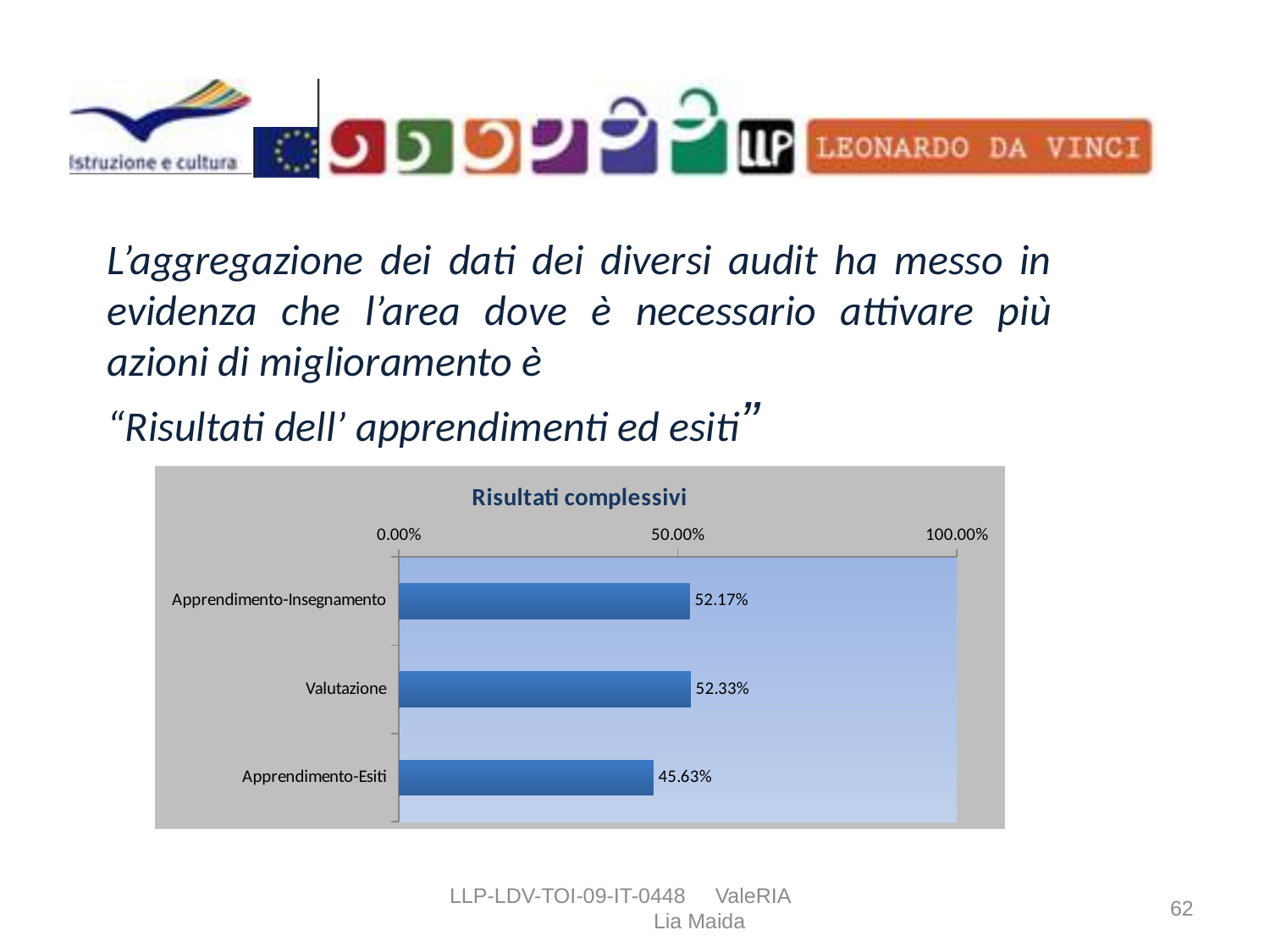
Which is larger, the value for Valutazione or the value for Apprendimento-Esiti? Valutazione What kind of chart is shown on the slide? bar chart Which category has the lowest value in the Risultati complessivi chart? Apprendimento-Esiti Which category has the highest value in the Risultati complessivi chart? Valutazione What is the value for Apprendimento-Insegnamento in the Risultati complessivi chart? 52.17% How many categories are shown in the Risultati complessivi chart? 3 Is the value for Apprendimento-Esiti greater or less than 50.00%? less What is the value for Valutazione in the Risultati complessivi chart? 52.33% What is the title of the chart on the slide? Risultati complessivi What is the value for Apprendimento-Esiti in the Risultati complessivi chart? 45.63% What is the difference between the values for Valutazione and Apprendimento-Esiti? 6.70% What is the difference between the values for Apprendimento-Insegnamento and Apprendimento-Esiti? 6.54%